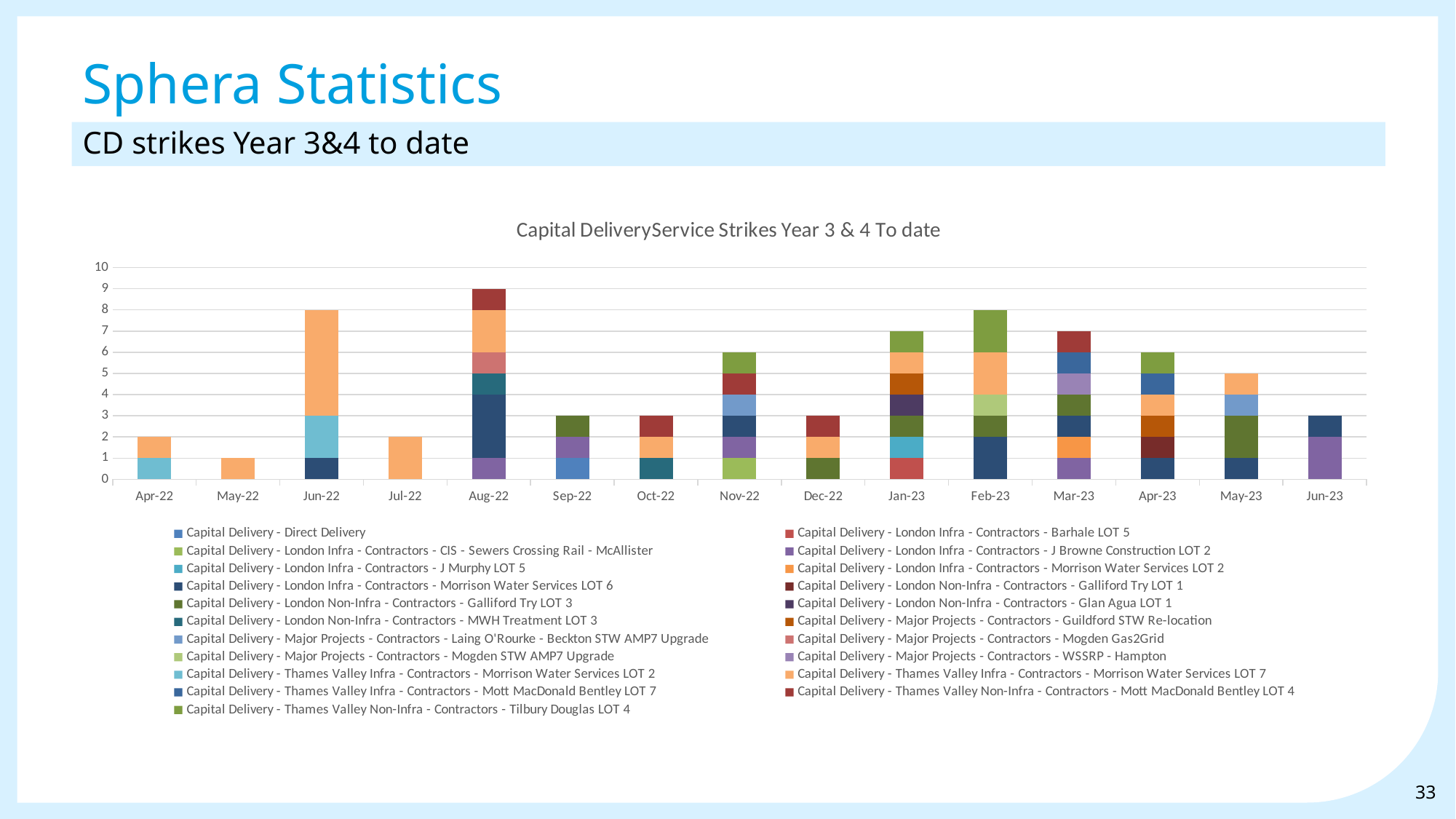
What is the difference between the total for Aug-22 and the total for May-22? 8 What is the total height of the stacked bar for Aug-22? 9 Is the total for Jun-22 greater or less than 5? greater Which month has the highest total stacked bar? Aug-22 How many series does the chart legend list? 21 Which month has a larger total, Aug-22 or Sep-22? Aug-22 Which month has the lowest total stacked bar? May-22 What is the title of the chart? Capital DeliveryService Strikes Year 3 & 4 To date What is the total height of the stacked bar for Jun-22? 8 What type of chart is shown on the slide? Stacked bar chart What is the total height of the stacked bar for Feb-23? 8 How many months are shown on the x axis of the chart? 15